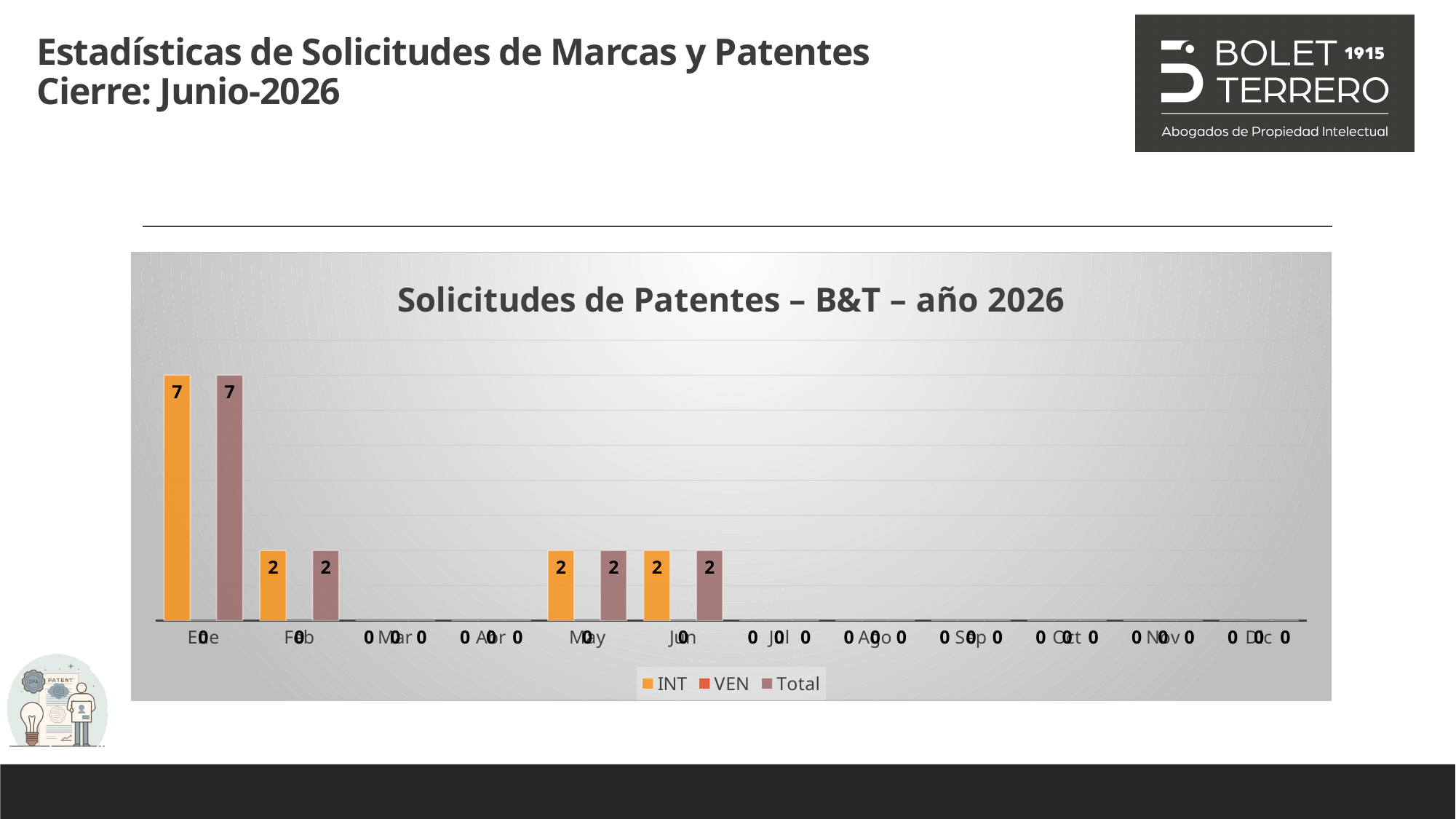
What is the difference between the INT value for Ene and the INT value for Jun? 5 What kind of chart is shown on the slide? bar chart How many series does the chart legend list? 3 What is the INT value for Ene? 7 What is the title of the chart? Solicitudes de Patentes – B&T – año 2026 How many months (categories) are shown on the x axis of the chart? 12 What is the Total value for Feb? 2 What is the Total value for Jul? 0 Which series are listed in the chart legend? INT, VEN, Total Which is larger, the Total value for Ene or the Total value for May? Ene What is the INT value for May? 2 Which month has the highest Total value? Ene